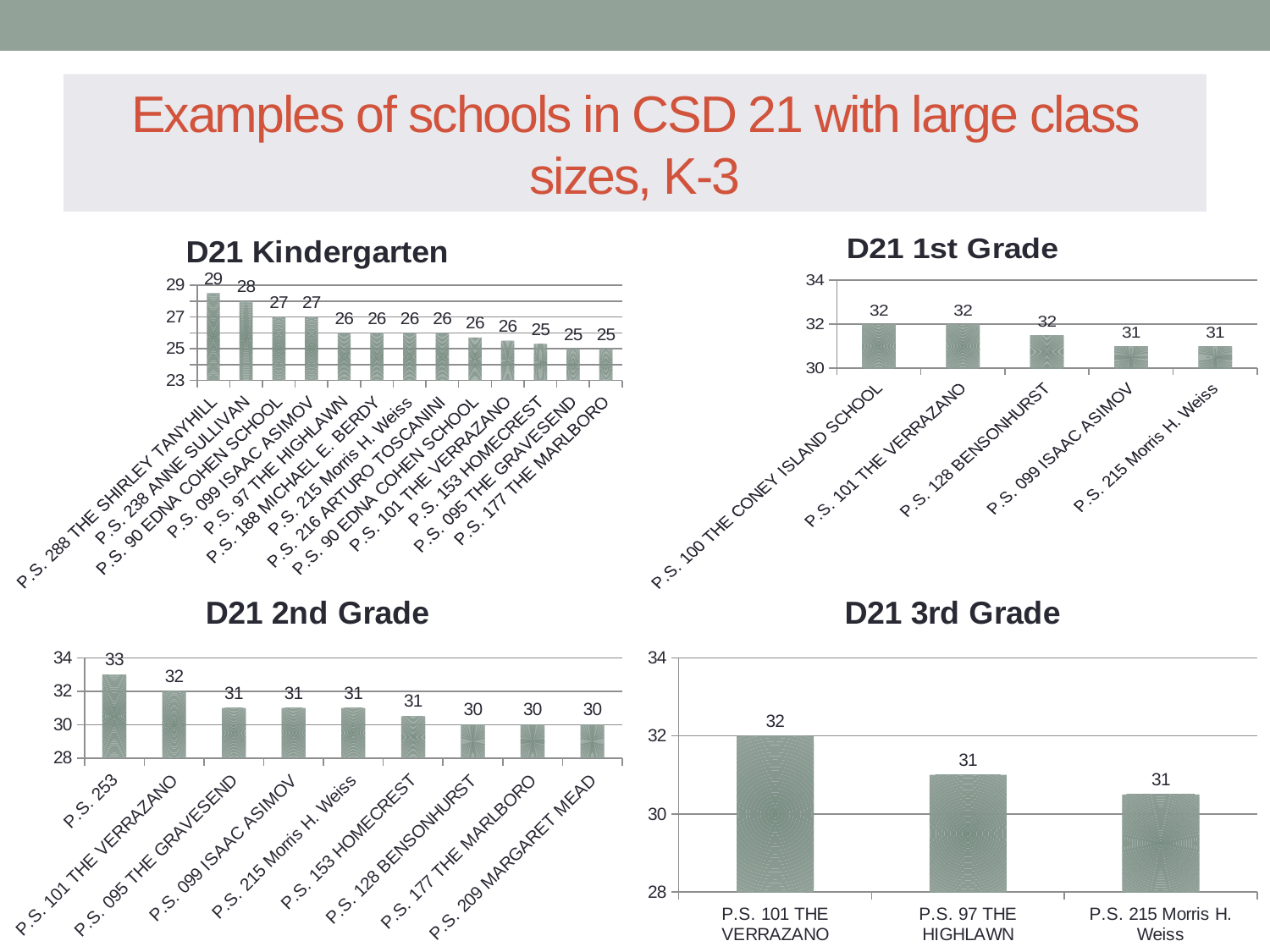
What kind of chart is the D21 3rd Grade chart? bar chart In the D21 1st Grade chart, what is the value for P.S. 099 ISAAC ASIMOV? 31 How many schools are shown in the D21 Kindergarten chart? 13 In the D21 Kindergarten chart, what is the difference between P.S. 288 THE SHIRLEY TANYHILL and P.S. 177 THE MARLBORO? 4 In the D21 2nd Grade chart, which school has the highest value? P.S. 253 In the D21 2nd Grade chart, what is the value for P.S. 128 BENSONHURST? 30 How many schools are shown in the D21 1st Grade chart? 5 In the D21 Kindergarten chart, which school has the highest value? P.S. 288 THE SHIRLEY TANYHILL In the D21 Kindergarten chart, what is the value for P.S. 288 THE SHIRLEY TANYHILL? 29 In the D21 2nd Grade chart, which is larger, the value for P.S. 101 THE VERRAZANO or the value for P.S. 209 MARGARET MEAD? P.S. 101 THE VERRAZANO In the D21 3rd Grade chart, what is the value for P.S. 101 THE VERRAZANO? 32 Do the values in the D21 3rd Grade chart rise or fall from left to right? fall